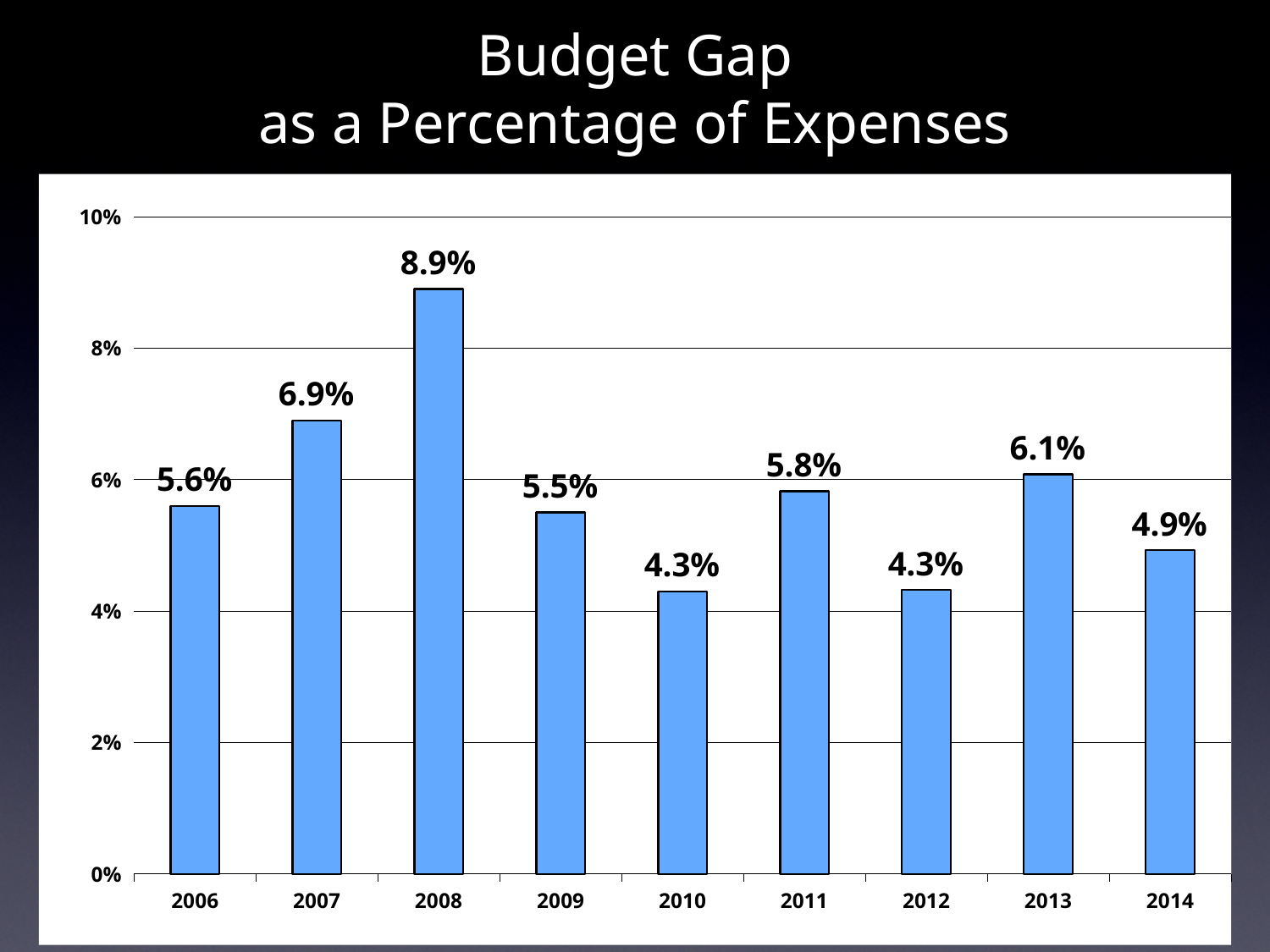
What is the title of the chart? Budget Gap as a Percentage of Expenses Which years share the lowest budget gap as a percentage of expenses? 2010 and 2012 What is the budget gap as a percentage of expenses for 2008? 8.9% How many years are shown on the x axis? 9 What is the budget gap as a percentage of expenses for 2011? 5.8% What kind of chart is shown on the slide? Bar chart Is the value for 2007 greater or less than 6%? greater What is the difference between the budget gap percentages for 2008 and 2007? 2.0% What is the difference between the budget gap percentages for 2013 and 2014? 1.2% What is the budget gap as a percentage of expenses for 2014? 4.9% Which year has a larger budget gap as a percentage of expenses, 2006 or 2009? 2006 Which year has the highest budget gap as a percentage of expenses? 2008